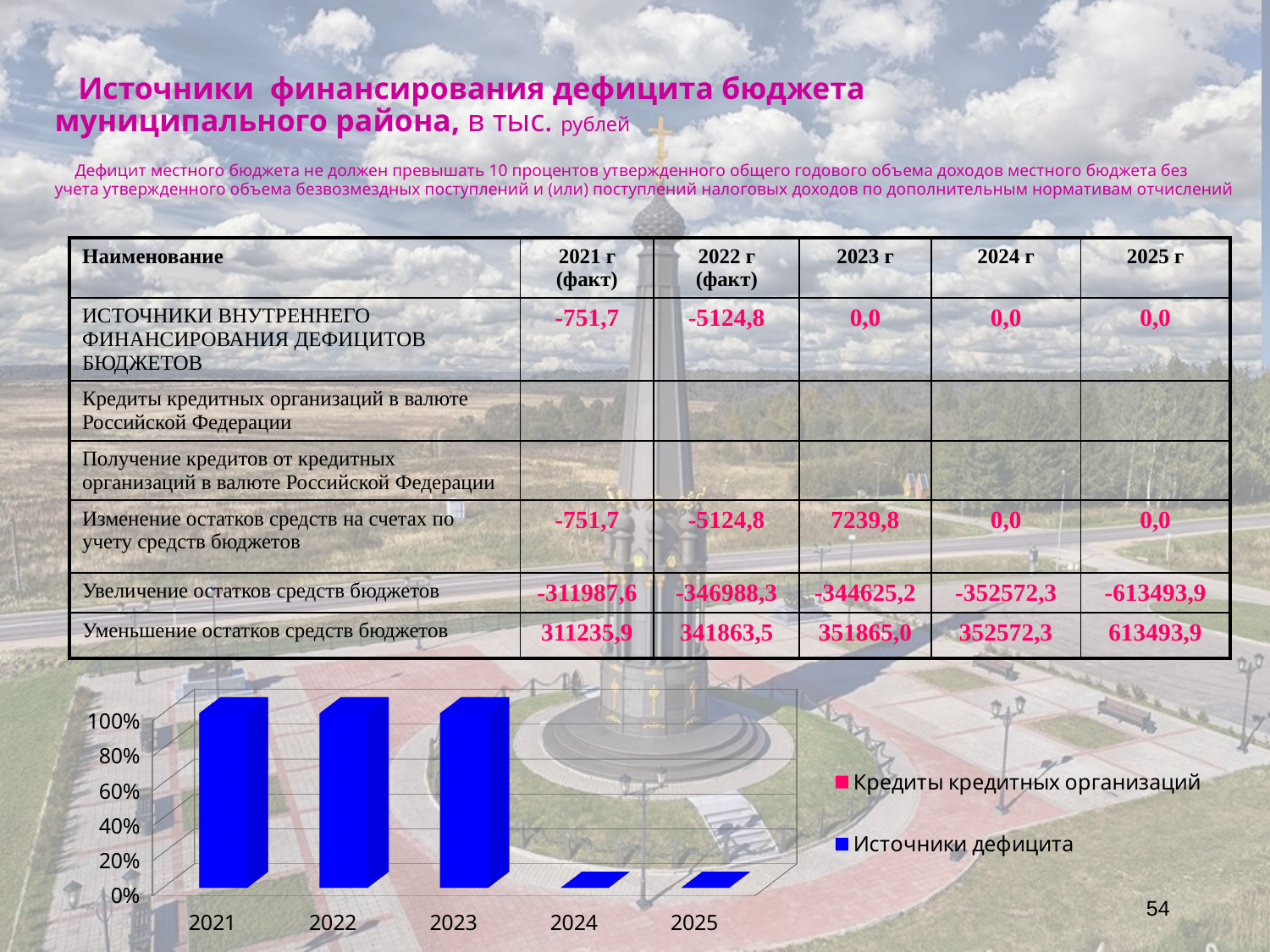
Is the value of the blue bar for 2024 greater or less than 20%? less What kind of chart is shown at the bottom of the slide? bar chart Is the value of the blue bar for 2023 greater or less than 60%? greater How many series does the legend of the bar chart list? 2 Which year has a taller blue bar in the chart, 2022 or 2025? 2022 Which series in the bar chart is shown in pink? Кредиты кредитных организаций What is the first year shown on the x axis of the bar chart? 2021 How many years are shown on the x axis of the bar chart? 5 Is the value of the blue bar for 2021 greater or less than 80%? greater Which year has a taller blue bar in the chart, 2024 or 2023? 2023 Which series in the bar chart is shown in blue? Источники дефицита